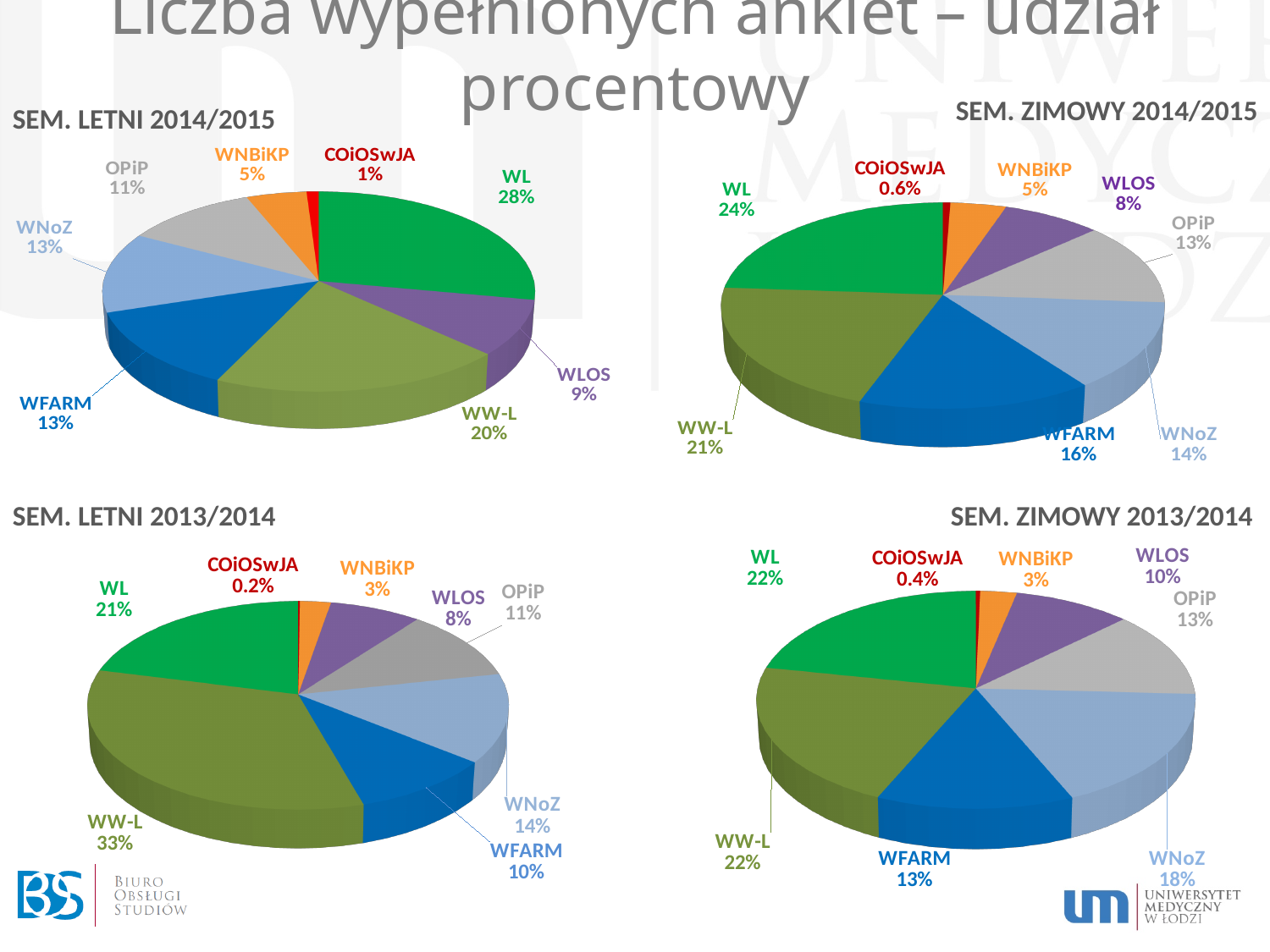
In the SEM. LETNI 2013/2014 chart, which category has the smallest share? COiOSwJA In the SEM. LETNI 2014/2015 chart, which category has the largest share? WL How many categories are shown in the SEM. LETNI 2014/2015 chart? 8 In the SEM. ZIMOWY 2014/2015 chart, what share does COiOSwJA have? 0.6% In the SEM. ZIMOWY 2013/2014 chart, which is larger: the share of WLOS or the share of OPiP? OPiP In the SEM. ZIMOWY 2013/2014 chart, what share does WNoZ have? 18% In the SEM. LETNI 2013/2014 chart, what share does WFARM have? 10% How many charts are on the slide? 4 In the SEM. LETNI 2013/2014 chart, what share does WW-L have? 33% What kind of chart is used for SEM. ZIMOWY 2013/2014? Pie chart In the SEM. ZIMOWY 2014/2015 chart, what is the difference between the shares of WW-L and WFARM? 5% In the SEM. LETNI 2014/2015 chart, what share does WL have? 28%